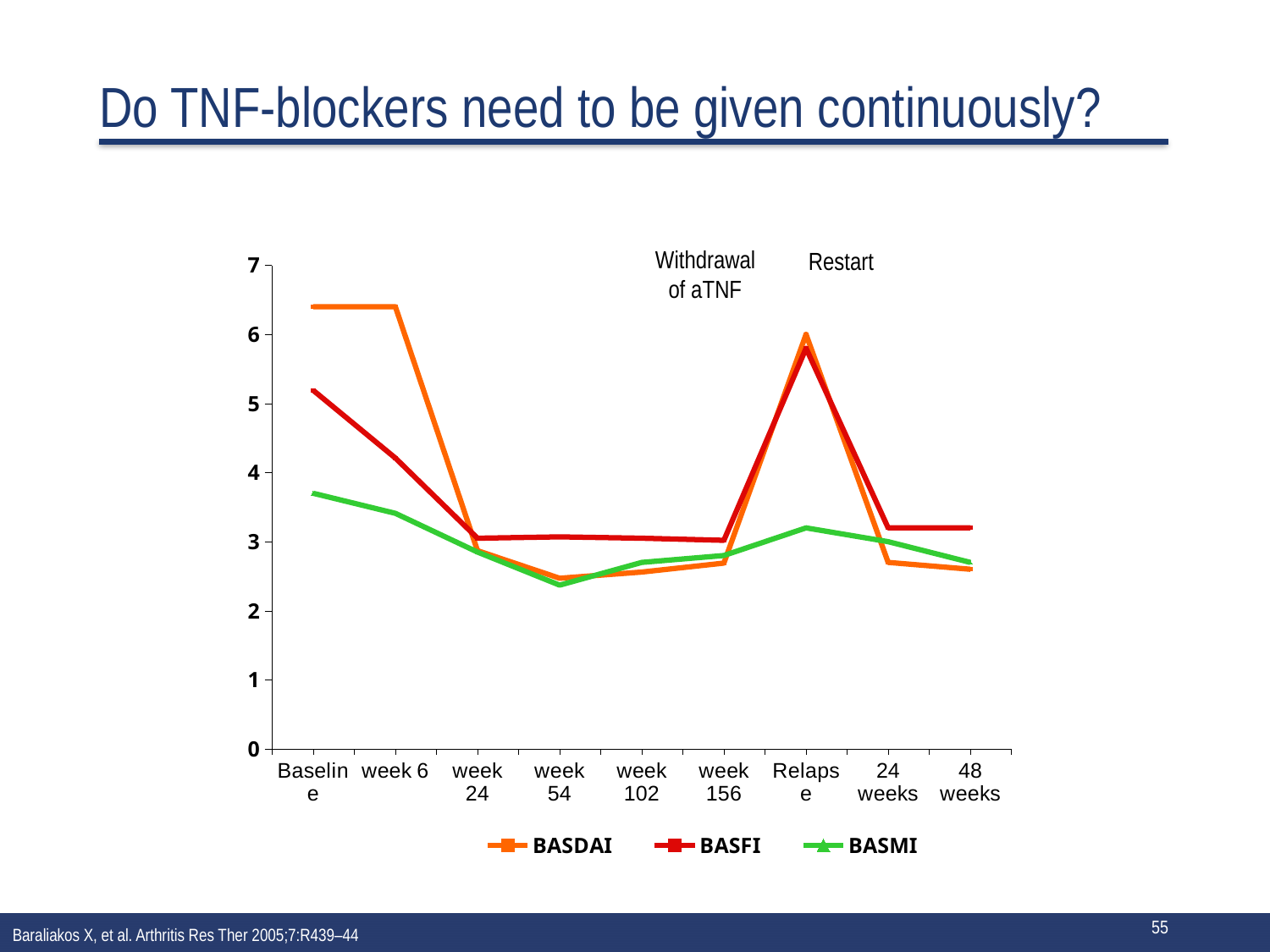
Which series has the lowest value at Baseline? BASMI Is the BASDAI value at Relapse greater or less than 5? greater How many time points are plotted along the x axis? 9 How many series does the legend list? 3 Which series is drawn in green? BASMI At 48 weeks, which is larger, BASFI or BASMI? BASFI What kind of chart is shown on the slide? line chart Is the BASDAI value at Baseline greater or less than 6? greater Is the BASMI value at Baseline greater or less than 4? less Does the BASDAI line rise or fall between week 6 and week 24? fall Which series has the highest value at Baseline? BASDAI